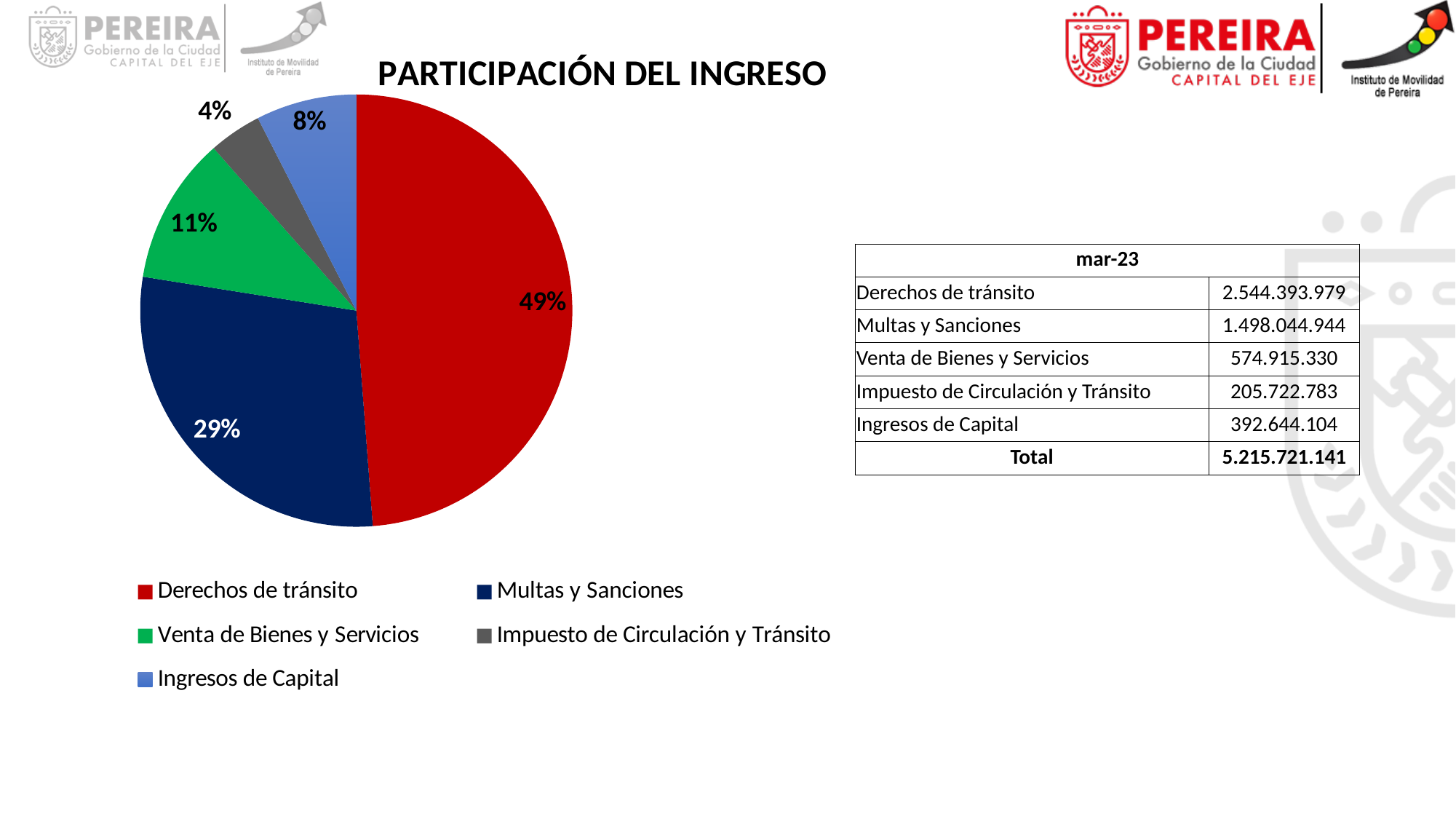
What kind of chart is shown on the slide? Pie chart What share of the pie does Impuesto de Circulación y Tránsito represent? 4% Which category has the smallest slice of the pie? Impuesto de Circulación y Tránsito What share of the pie does Venta de Bienes y Servicios represent? 11% Which category has the largest slice of the pie? Derechos de tránsito What is the title of the chart? PARTICIPACIÓN DEL INGRESO What share of the pie does Derechos de tránsito represent? 49% How many categories does the pie chart show? 5 Which slice is larger, Venta de Bienes y Servicios or Ingresos de Capital? Venta de Bienes y Servicios What is the difference in percentage points between the Derechos de tránsito slice and the Multas y Sanciones slice? 20%